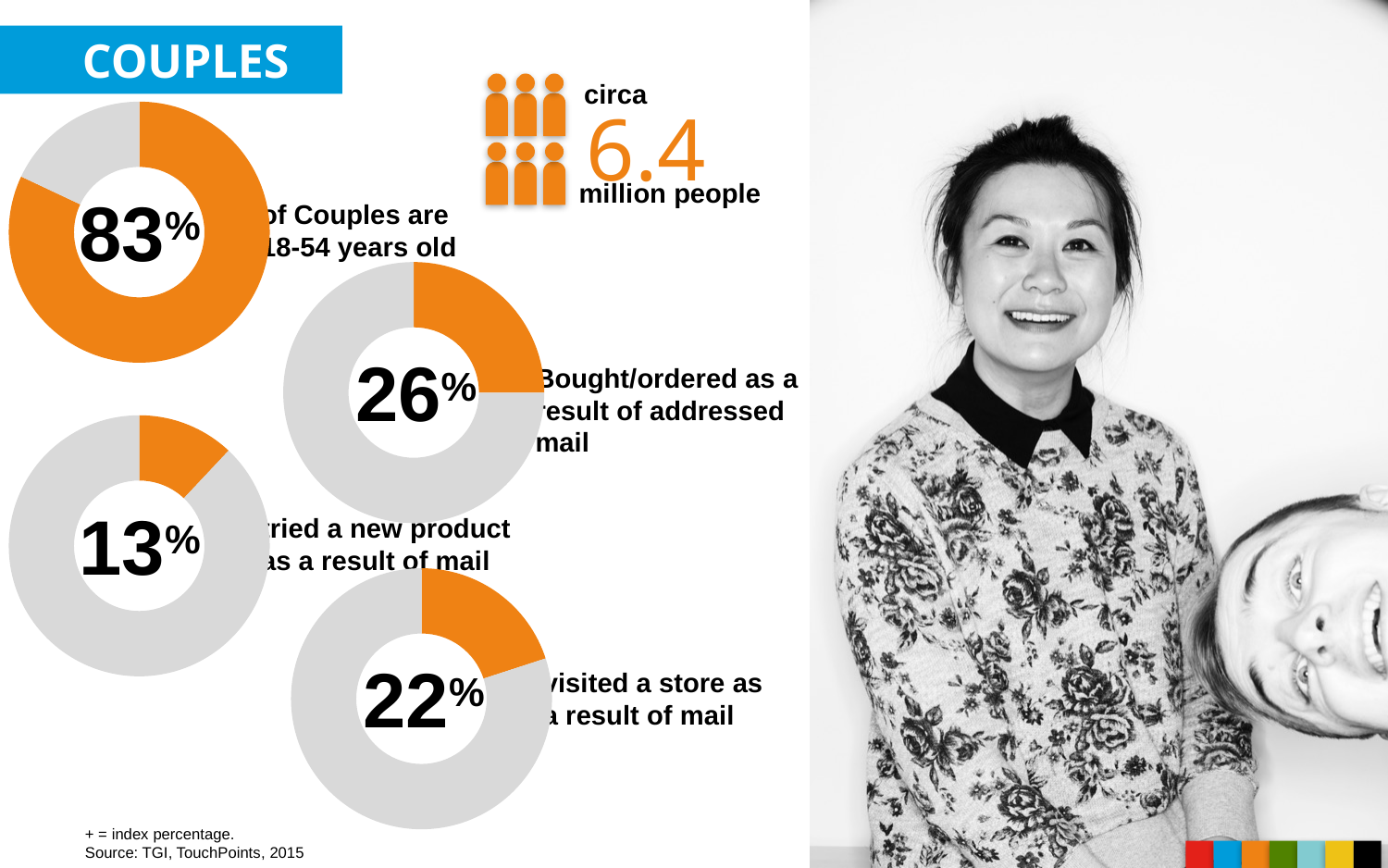
What type of chart is used to show the percentages on this slide? Donut (pie) chart What percentage of Couples bought/ordered as a result of addressed mail? 26% Which of the four donut charts on the slide shows the lowest percentage? 13% (tried a new product as a result of mail) Which is larger: the percentage who visited a store as a result of mail or the percentage who tried a new product as a result of mail? Visited a store as a result of mail (22%) What percentage of Couples visited a store as a result of mail? 22% How many donut charts are shown on the slide? 4 What percentage of Couples are 18-54 years old, according to the top-left donut chart? 83% What is the difference between the percentage who visited a store as a result of mail and the percentage who bought/ordered as a result of addressed mail? 4% Which of the four donut charts on the slide shows the highest percentage? 83% (Couples aged 18-54 years old) Approximately how many people does the Couples segment represent, according to the slide? circa 6.4 million people What is the difference between the percentage who bought/ordered as a result of addressed mail and the percentage who tried a new product as a result of mail? 13% What percentage of Couples tried a new product as a result of mail? 13%